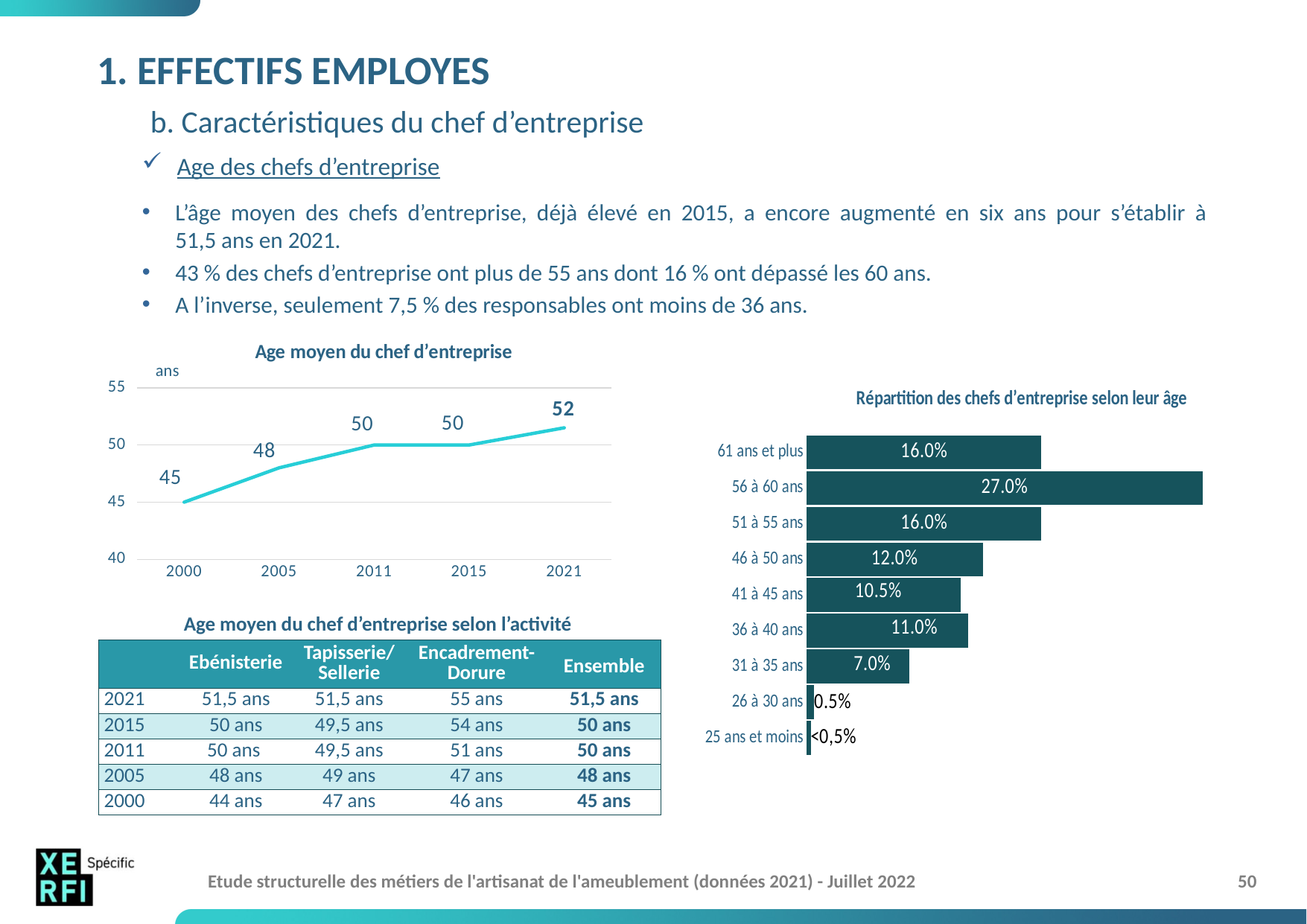
In the chart 'Répartition des chefs d'entreprise selon leur âge', which age group has the highest share? 56 à 60 ans In the chart 'Répartition des chefs d'entreprise selon leur âge', what is the difference between '56 à 60 ans' and '31 à 35 ans'? 20.0% In the chart 'Répartition des chefs d'entreprise selon leur âge', what is the value for '56 à 60 ans'? 27.0% In the chart 'Age moyen du chef d'entreprise', what is the value for 2000? 45 In the chart 'Répartition des chefs d'entreprise selon leur âge', what is the value for '41 à 45 ans'? 10.5% In the chart 'Répartition des chefs d'entreprise selon leur âge', how many age groups are shown? 9 In the chart 'Age moyen du chef d'entreprise', how many years are plotted on the x axis? 5 In the chart 'Age moyen du chef d'entreprise', what kind of chart is shown? line chart In the chart 'Répartition des chefs d'entreprise selon leur âge', which is larger, '46 à 50 ans' or '36 à 40 ans'? 46 à 50 ans In the chart 'Age moyen du chef d'entreprise', do the values rise or fall from 2000 to 2021? rise In the chart 'Age moyen du chef d'entreprise', what is the value for 2021? 52 In the chart 'Age moyen du chef d'entreprise', what is the difference between the 2021 value and the 2000 value? 7